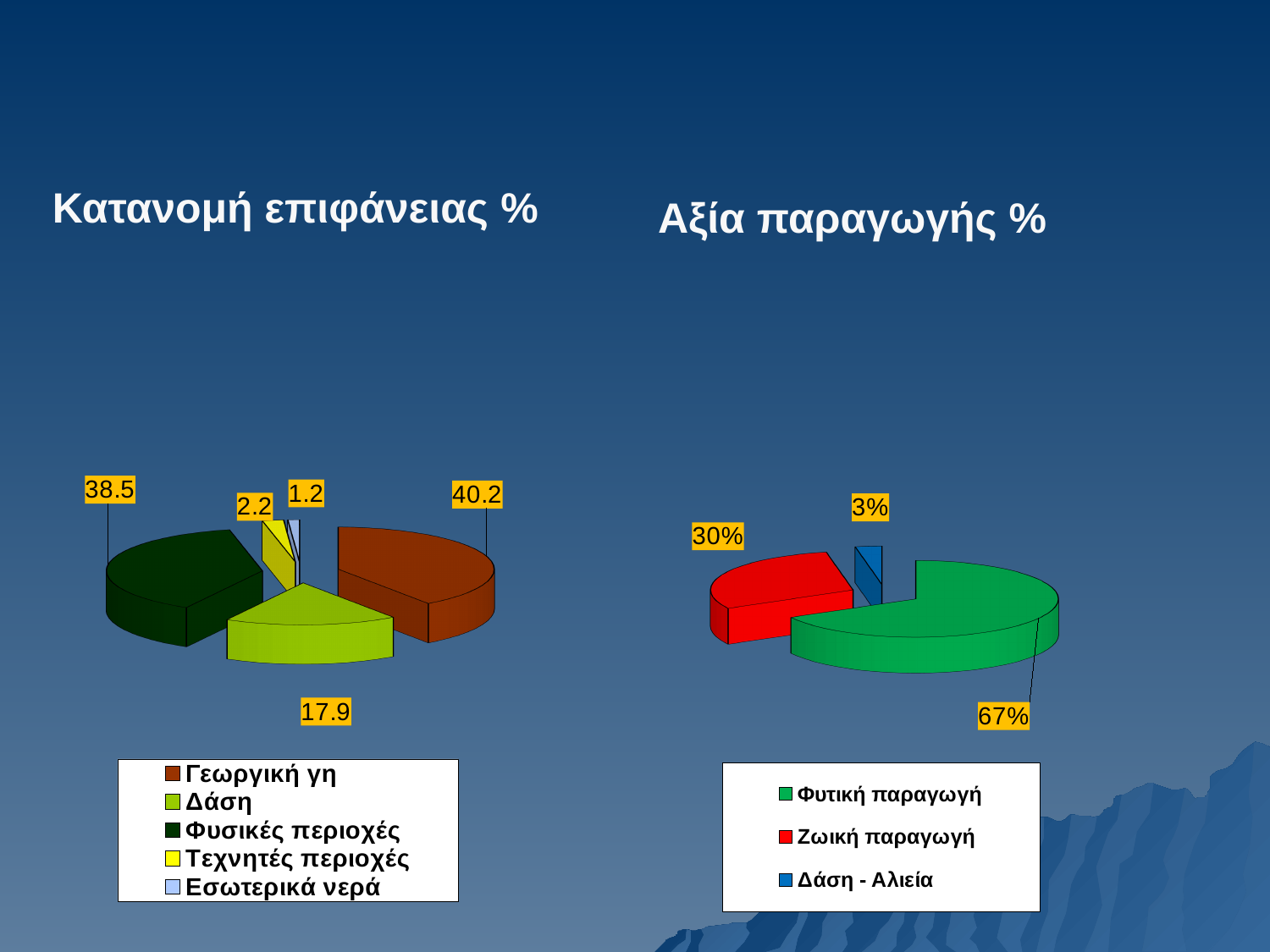
In the chart titled "Αξία παραγωγής %", which category has the largest share? Φυτική παραγωγή In the chart titled "Κατανομή επιφάνειας %", which category has the largest slice? Γεωργική γη What kind of chart is the chart titled "Αξία παραγωγής %"? Pie chart In the chart titled "Αξία παραγωγής %", what is the difference between Φυτική παραγωγή and Ζωική παραγωγή? 37% In the chart titled "Κατανομή επιφάνειας %", which category has the smallest slice? Εσωτερικά νερά In the chart titled "Κατανομή επιφάνειας %", what is the difference between the values for Φυσικές περιοχές and Δάση? 20.6 In the chart titled "Κατανομή επιφάνειας %", what is the value for Εσωτερικά νερά? 1.2 In the chart titled "Αξία παραγωγής %", what is the value for Ζωική παραγωγή? 30% In the chart titled "Κατανομή επιφάνειας %", how many categories are shown? 5 In the chart titled "Κατανομή επιφάνειας %", what is the value for Δάση? 17.9 In the chart titled "Κατανομή επιφάνειας %", what is the value for Γεωργική γη? 40.2 In the chart titled "Αξία παραγωγής %", what is the value for Δάση - Αλιεία? 3%